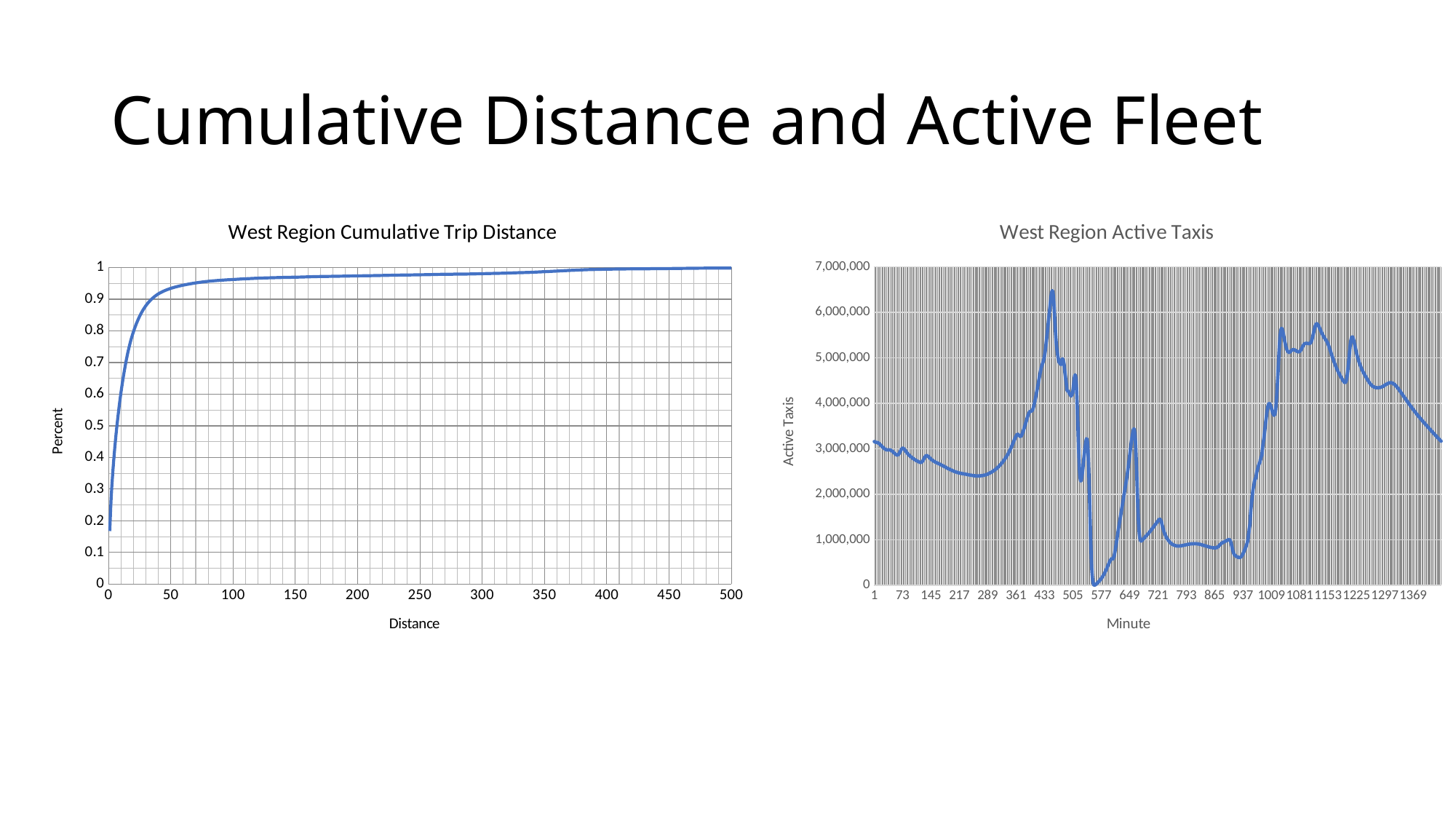
In the 'West Region Cumulative Trip Distance' chart, do the values rise or fall as Distance increases? rise In the 'West Region Active Taxis' chart, is the highest peak of the line greater or less than 6,000,000? greater What kind of chart is the 'West Region Cumulative Trip Distance' chart on the left? line chart In the 'West Region Active Taxis' chart, is the value at Minute 577 greater or less than 1,000,000? less In the 'West Region Cumulative Trip Distance' chart, is the value at a Distance of 50 greater or less than 0.9? greater What is the label of the vertical axis in the 'West Region Cumulative Trip Distance' chart? Percent What kind of chart is the 'West Region Active Taxis' chart on the right? line chart In the 'West Region Active Taxis' chart, what is the highest value shown on the vertical axis? 7,000,000 What is the label of the horizontal axis in the 'West Region Active Taxis' chart? Minute